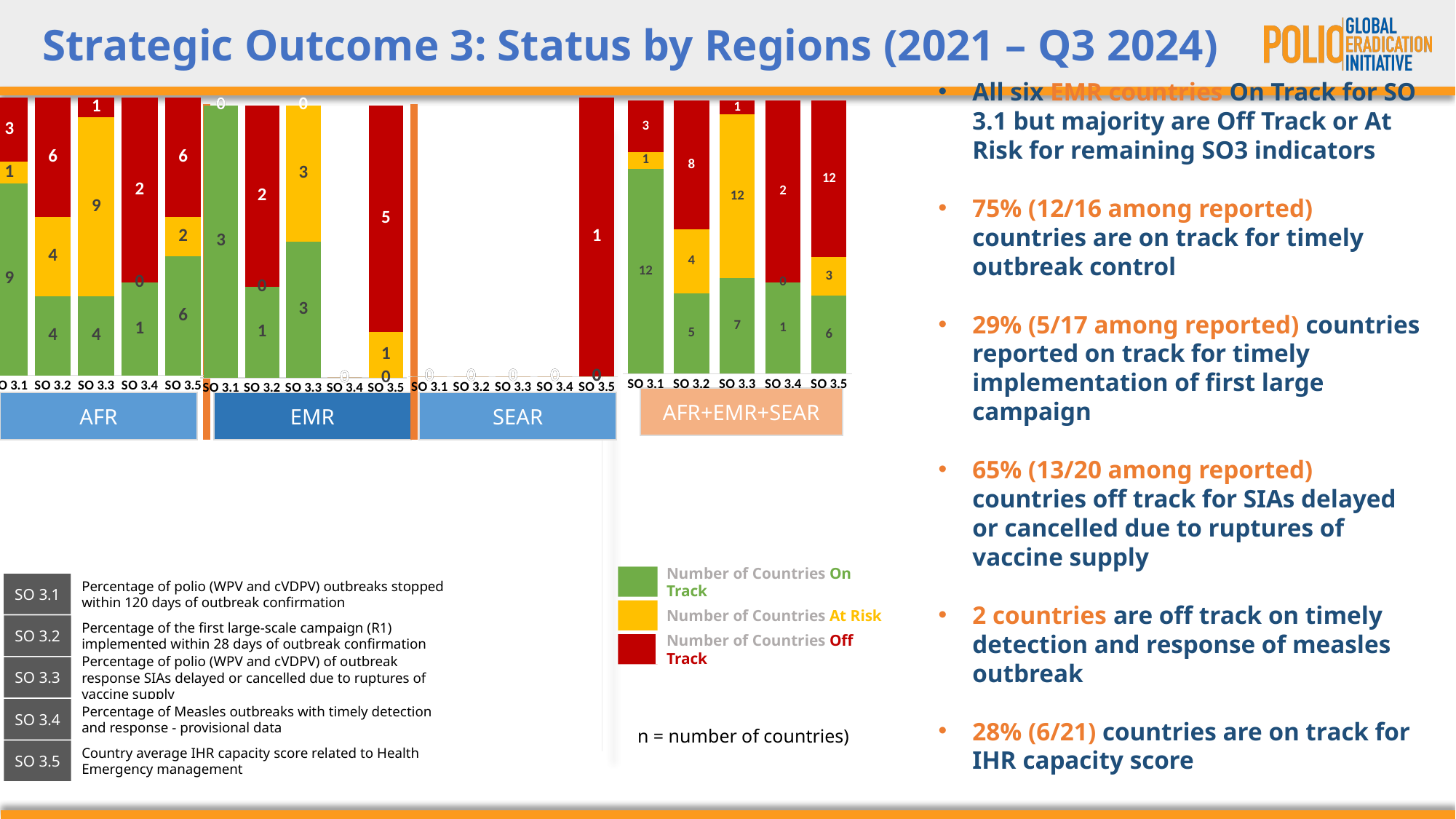
In the AFR group, how many countries are At Risk for SO 3.3? 9 In the AFR+EMR+SEAR group, which indicator has the highest number of Off Track countries? SO 3.5 In the AFR+EMR+SEAR group, how many countries are Off Track for SO 3.2? 8 What is the total number of countries in the AFR+EMR+SEAR SO 3.5 bar? 21 In the AFR group for SO 3.2, what is the difference between the number of Off Track countries and the number of On Track countries? 2 How many region groups are shown along the x axis of the chart? 4 In the AFR group, which is larger: the number of At Risk countries for SO 3.3 or for SO 3.2? SO 3.3 In the AFR group, how many countries are On Track for SO 3.1? 9 In the EMR group, how many countries are Off Track for SO 3.5? 5 In the AFR+EMR+SEAR group, which indicator has the highest number of On Track countries? SO 3.1 How many series does the chart legend list? 3 What kind of chart is shown on the slide? Stacked bar chart